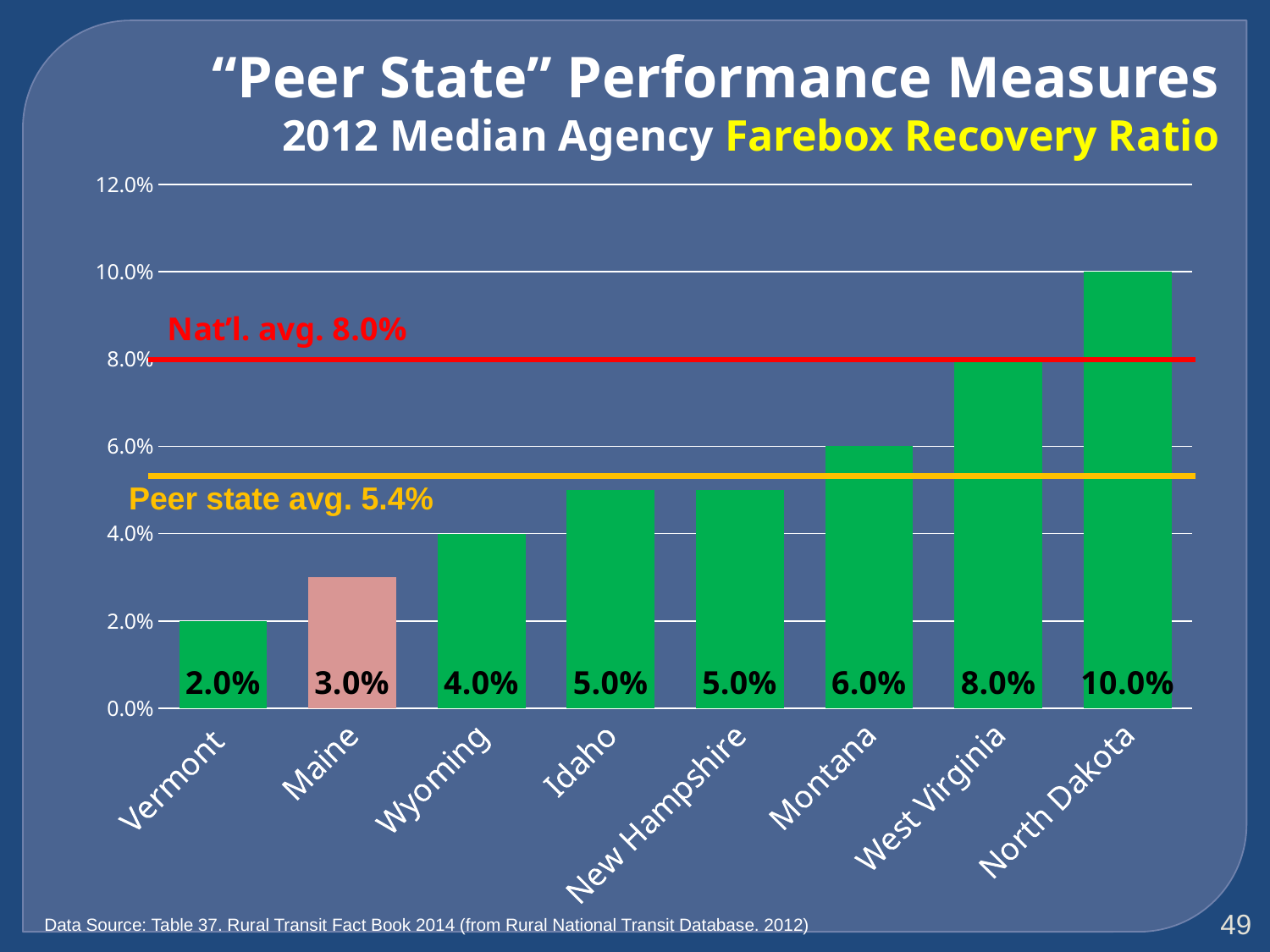
What is the difference between North Dakota's and Maine's farebox recovery ratios? 7.0% What is the 2012 median agency farebox recovery ratio for Maine? 3.0% Which state has the lowest farebox recovery ratio on the chart? Vermont What is the farebox recovery ratio for Idaho? 5.0% What is the national average farebox recovery ratio indicated by the red line? 8.0% Which has a higher farebox recovery ratio, Montana or Wyoming? Montana Do the farebox recovery ratios rise or fall moving from left to right across the states? Rise How many states are shown on the chart? 8 Which state has the highest farebox recovery ratio on the chart? North Dakota What is the peer state average farebox recovery ratio indicated by the yellow line? 5.4% What is the farebox recovery ratio shown for West Virginia? 8.0% What kind of chart is used to show the farebox recovery ratios? Bar chart